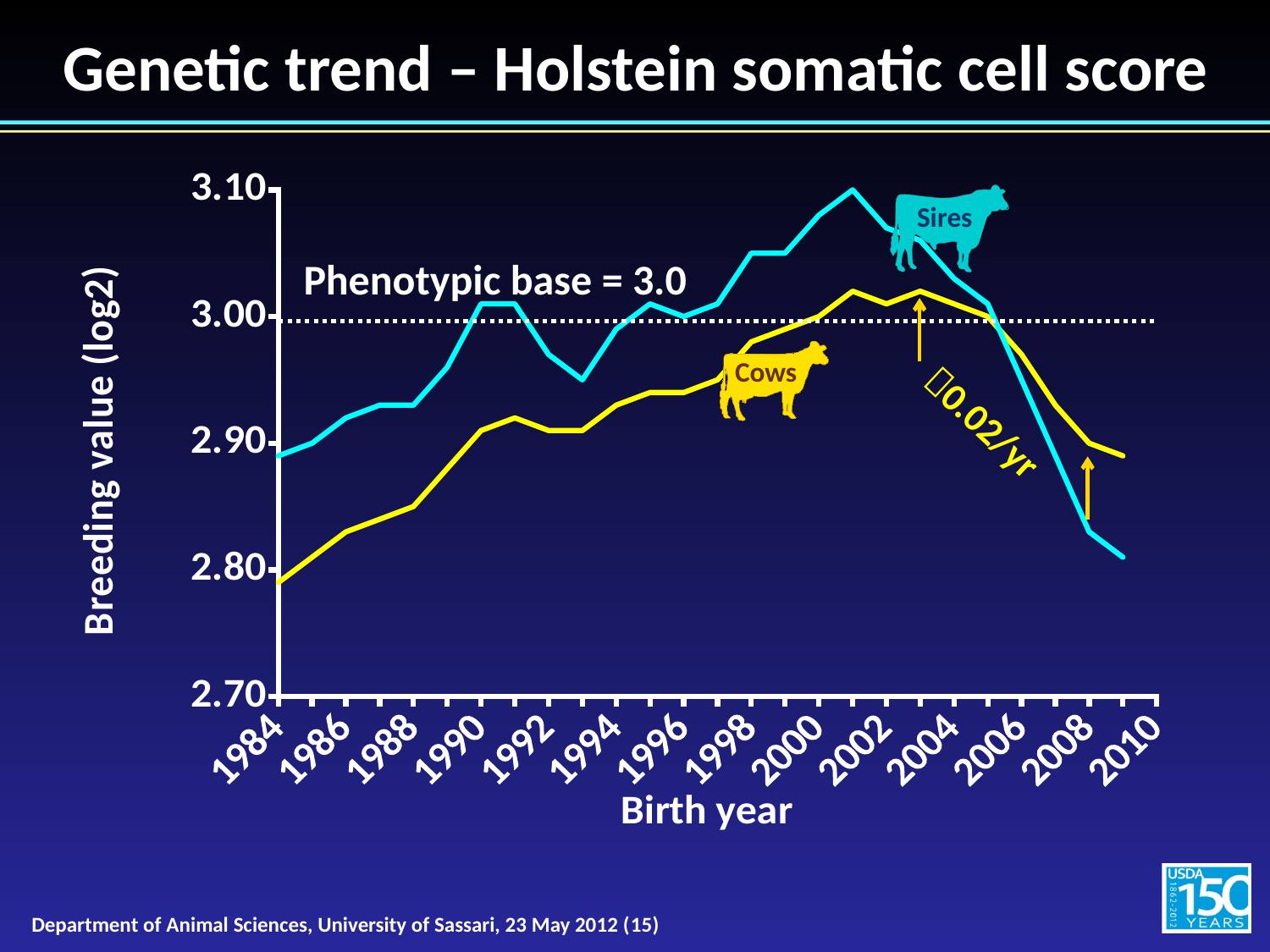
What kind of chart is shown on the slide? line chart What is the title of the chart on the slide? Genetic trend – Holstein somatic cell score Which series reaches the highest breeding value on the chart? Sires Is the Cows value for birth year 1984 greater or less than 2.90? less What is the label of the y axis? Breeding value (log2) How many series are plotted on the chart? 2 Do the Cows values generally rise or fall from birth year 1984 to 2003? rise Do the Sires values rise or fall from birth year 2004 to 2010? fall For birth year 1990, which series has the higher breeding value, Sires or Cows? Sires Is the Sires value for birth year 2001 greater or less than 3.00? greater